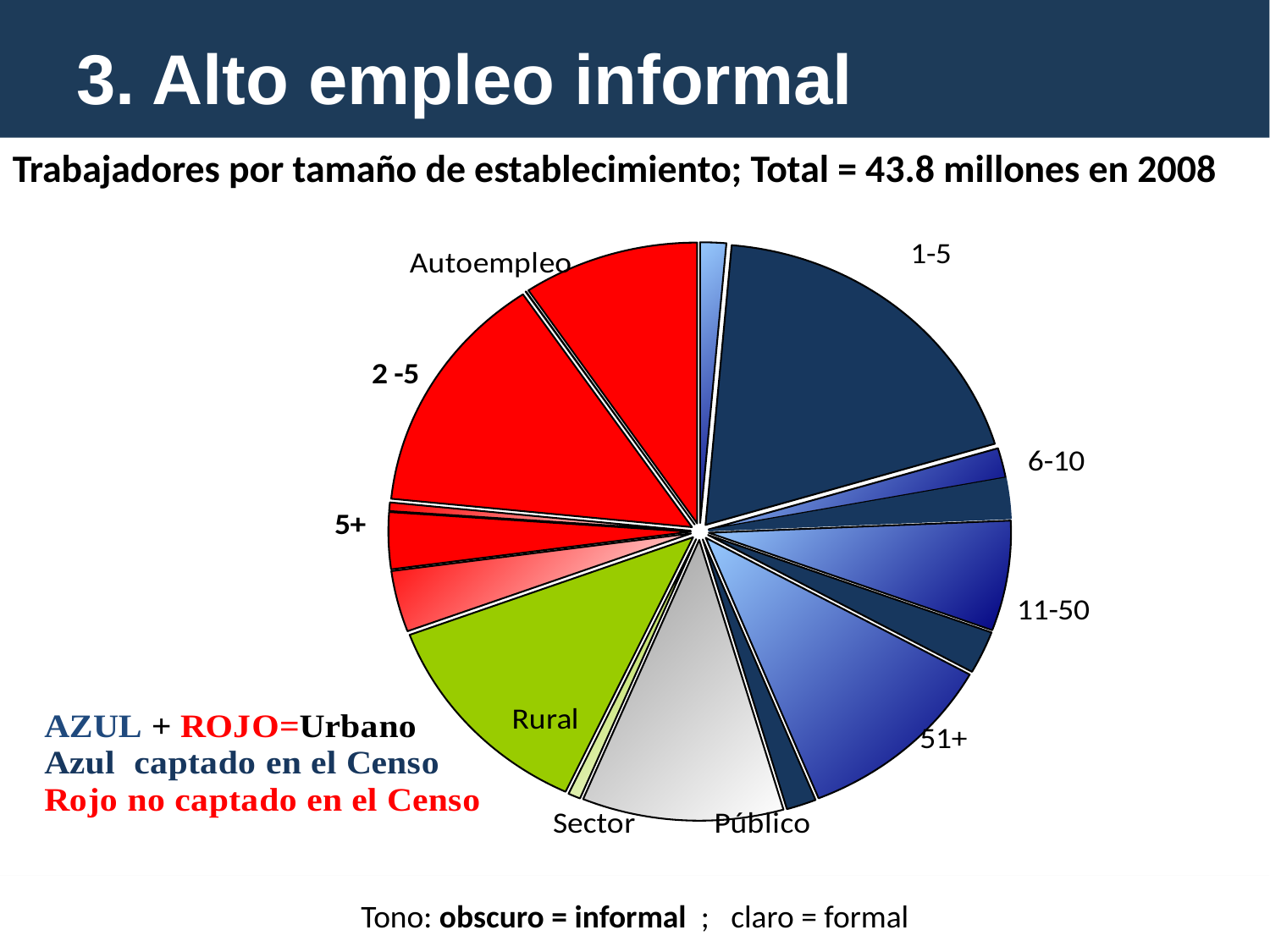
What is the title of the chart on the slide? Trabajadores por tamaño de establecimiento; Total = 43.8 millones en 2008 Which slice is larger, Autoempleo or 6-10? Autoempleo According to the note below the chart, what does a dark tone (obscuro) represent? informal Which slice is larger, 51+ or 6-10? 51+ Which slice is larger, 1-5 or 6-10? 1-5 What kind of chart is shown on the slide? pie chart